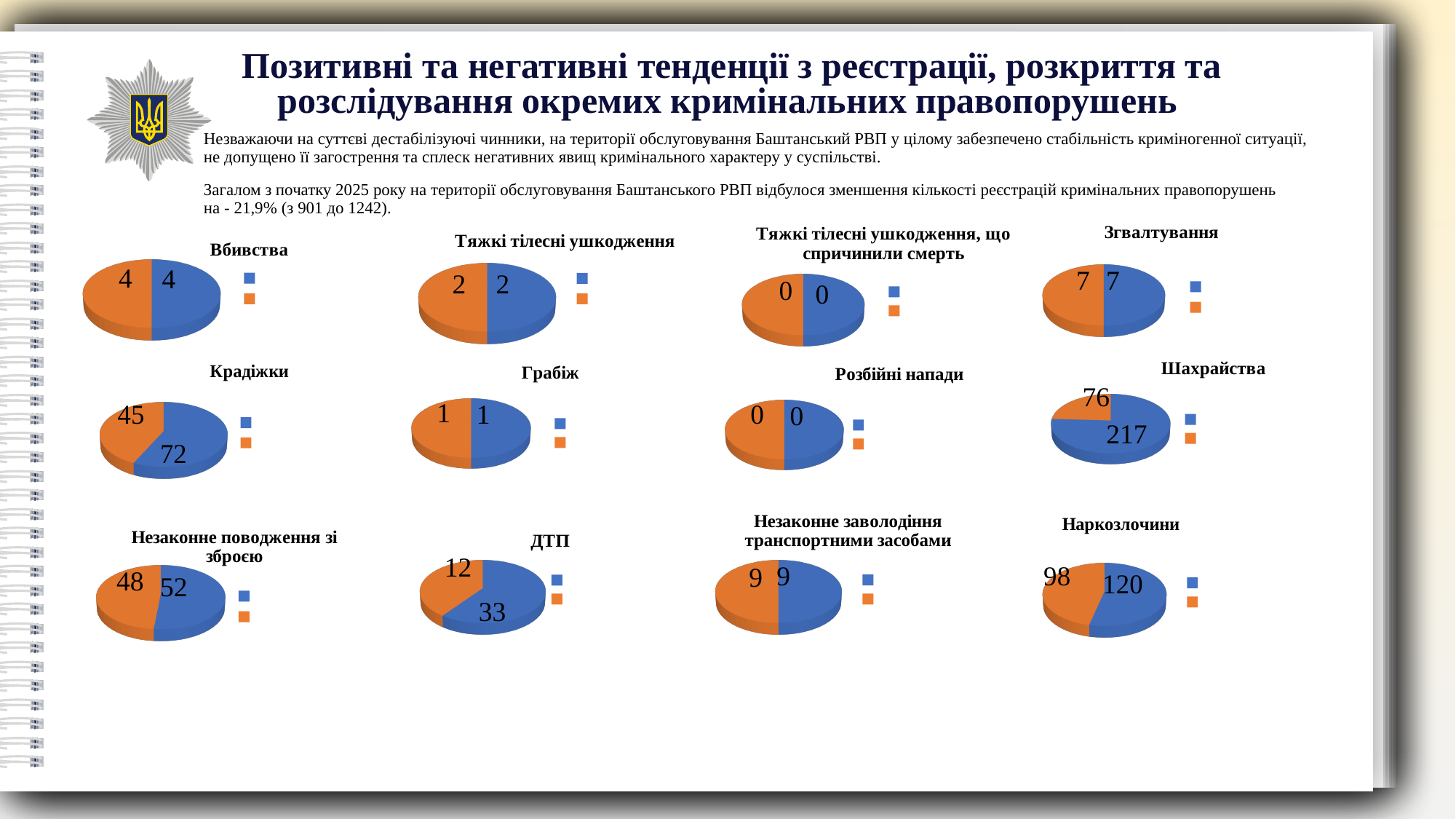
What kind of chart is used for "Згвалтування"? pie chart In the "Незаконне поводження зі зброєю" pie chart, what is the total of the two slices? 100 In the "ДТП" pie chart, what is the value of the orange slice? 12 In the "Крадіжки" pie chart, what is the value of the orange slice? 45 In the "Крадіжки" pie chart, which slice is larger, the blue one or the orange one? blue In the "Наркозлочини" pie chart, what is the total of the two slices? 218 In the "Шахрайства" pie chart, what is the value of the blue slice? 217 In the "Наркозлочини" pie chart, what is the value of the blue slice? 120 In the "ДТП" pie chart, what is the difference between the blue slice and the orange slice? 21 In the "Шахрайства" pie chart, what is the difference between the blue slice and the orange slice? 141 How many entries does the legend of the "Вбивства" chart list? 2 How many pie charts are shown on the slide? 12